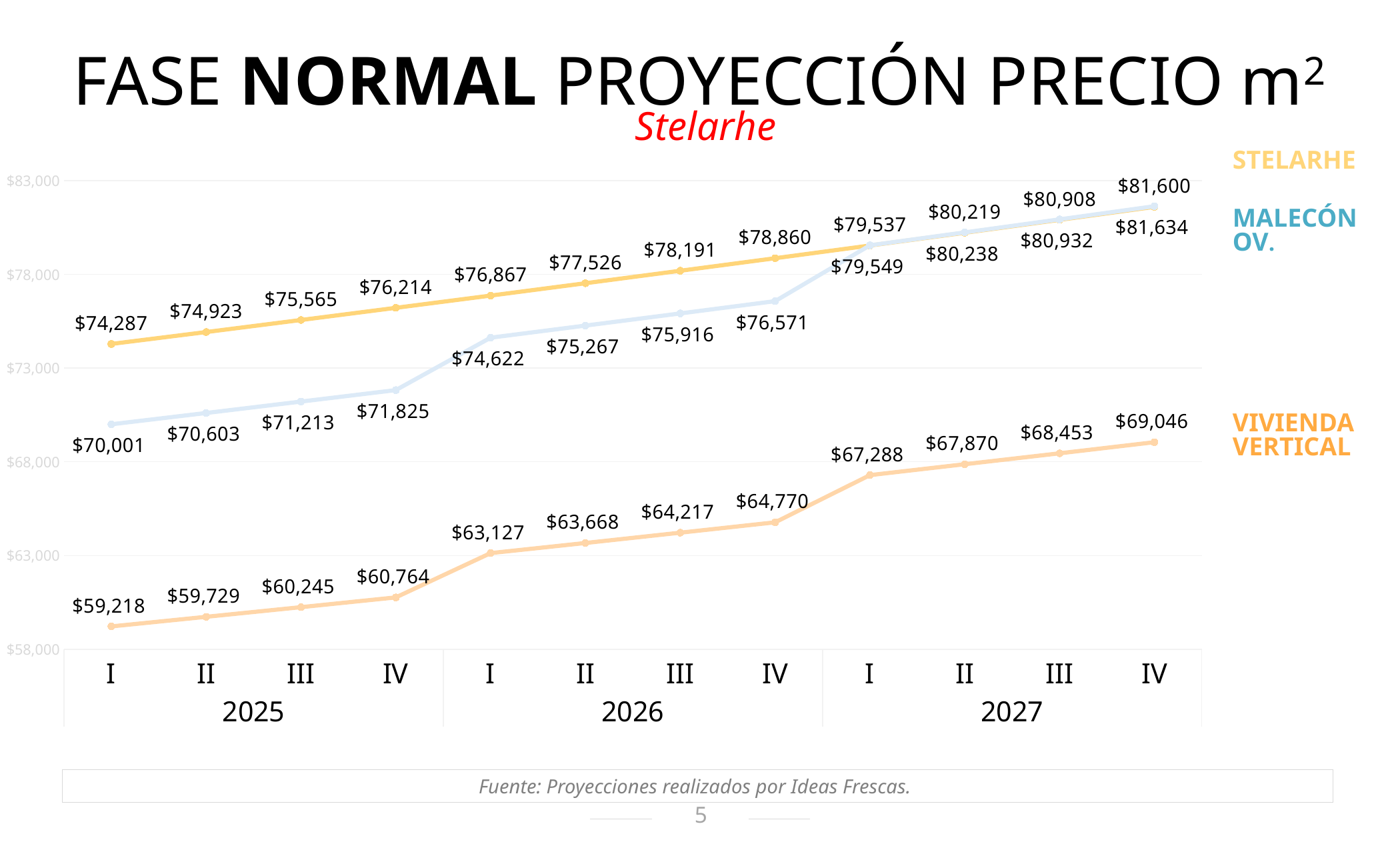
What is the difference between the STELARHE and MALECÓN OV. values in quarter I of 2025? $4,286 What type of chart is shown on the slide? line chart Which series has the lowest value in quarter IV of 2027? VIVIENDA VERTICAL How many series does the chart show? 3 Does the VIVIENDA VERTICAL series rise or fall from quarter I of 2025 to quarter IV of 2027? rise What is the MALECÓN OV. value in quarter IV of 2027? $81,634 How many quarterly points are plotted for each series? 12 Which series has the highest value in quarter I of 2025? STELARHE Is the STELARHE value or the MALECÓN OV. value larger in quarter IV of 2026? STELARHE What is the source cited below the chart? Proyecciones realizados por Ideas Frescas. What is the STELARHE value in quarter I of 2025? $74,287 What is the VIVIENDA VERTICAL value in quarter I of 2026? $63,127